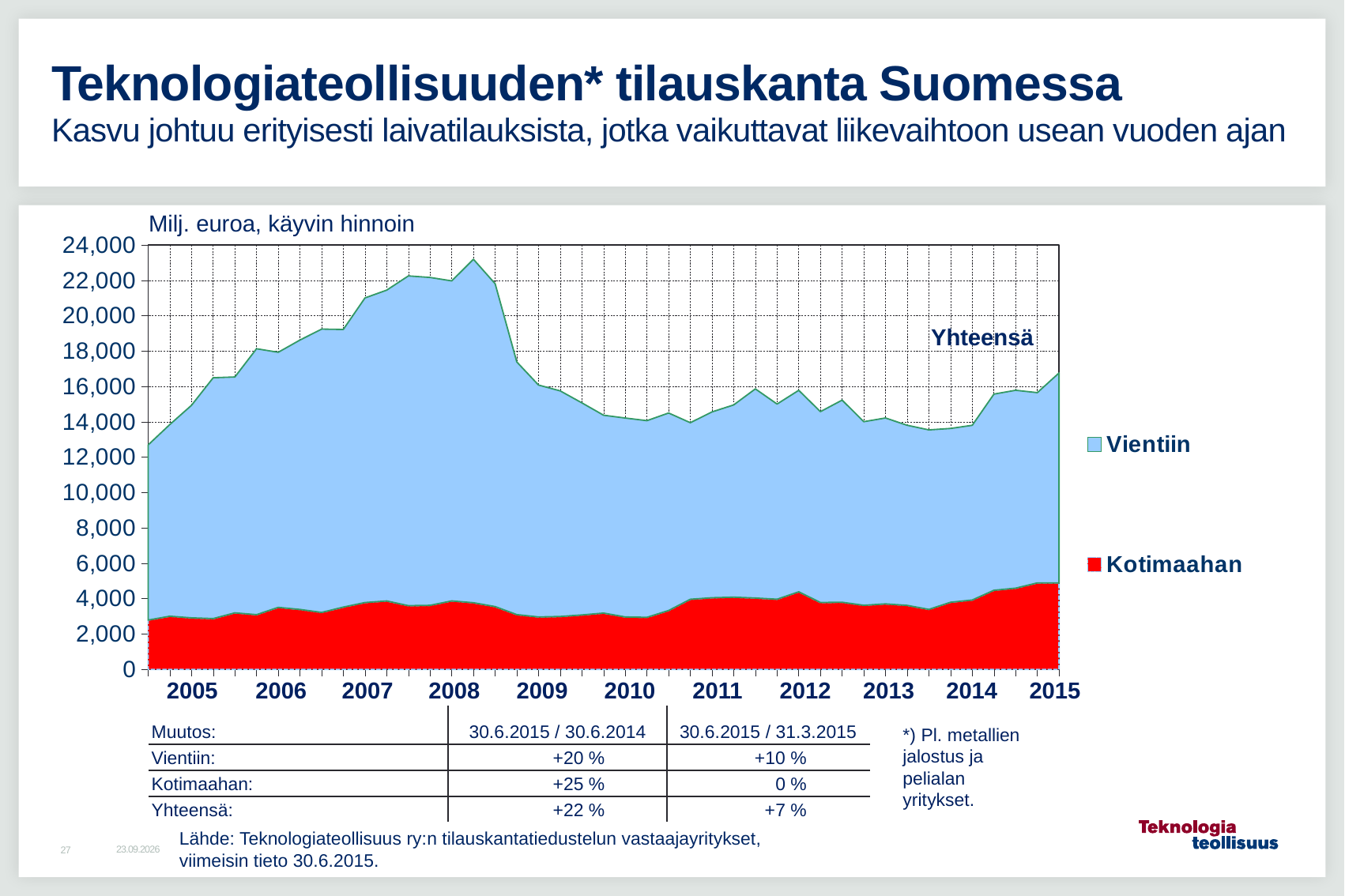
Is the total value at the start of 2005 greater or less than 14,000? less How many series does the chart legend list? 2 Is the peak total value in 2008 greater or less than 22,000? greater Is the Kotimaahan value at the end of the series in 2015 greater or less than 4,000? greater What kind of chart is shown on the slide? Stacked area chart What unit label is shown above the chart's y-axis? Milj. euroa, käyvin hinnoin Which series is larger throughout the chart, Vientiin or Kotimaahan? Vientiin In which year does the total (Yhteensä) order book reach its highest level? 2008 How many year labels are shown on the x-axis? 11 What are the two series named in the chart legend? Vientiin and Kotimaahan Does the total order book rise or fall between 2008 and 2009? Fall